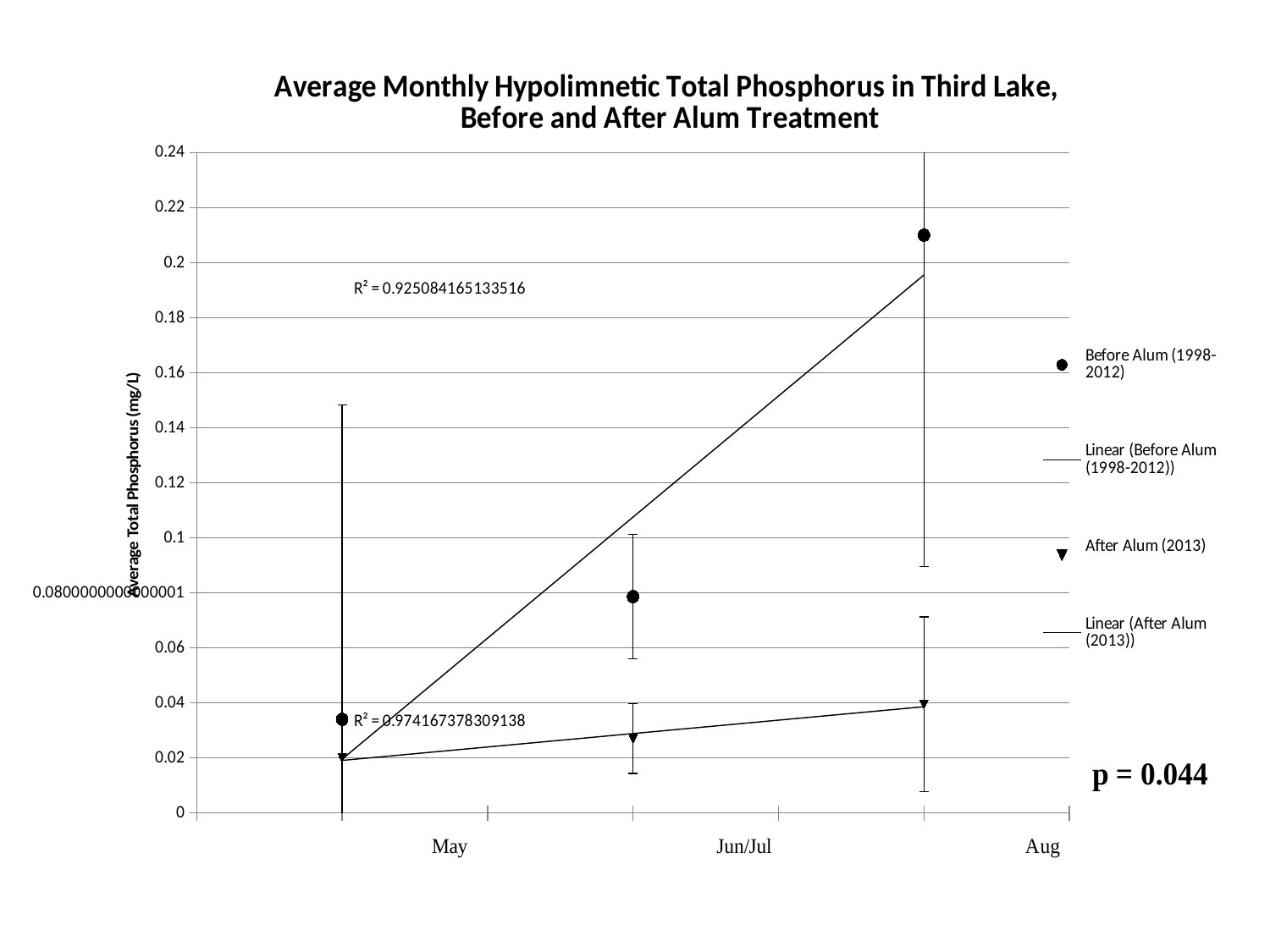
What p value is printed on the slide? p = 0.044 At Aug, which series has the larger value, Before Alum (1998-2012) or After Alum (2013)? Before Alum (1998-2012) Which time period has the lowest After Alum (2013) value? May Is the Before Alum (1998-2012) value for Jun/Jul greater or less than 0.06? greater How many entries does the chart legend list? 4 Is the After Alum (2013) value for Aug greater or less than 0.06? less How many time periods are labelled on the x axis? 3 Which time period has the highest Before Alum (1998-2012) value? Aug What kind of chart is shown on the slide? scatter chart Is the Before Alum (1998-2012) value for Aug greater or less than 0.2? greater What is the y-axis title of the chart? Average Total Phosphorus (mg/L) Do the Before Alum (1998-2012) values rise or fall from May to Aug? rise